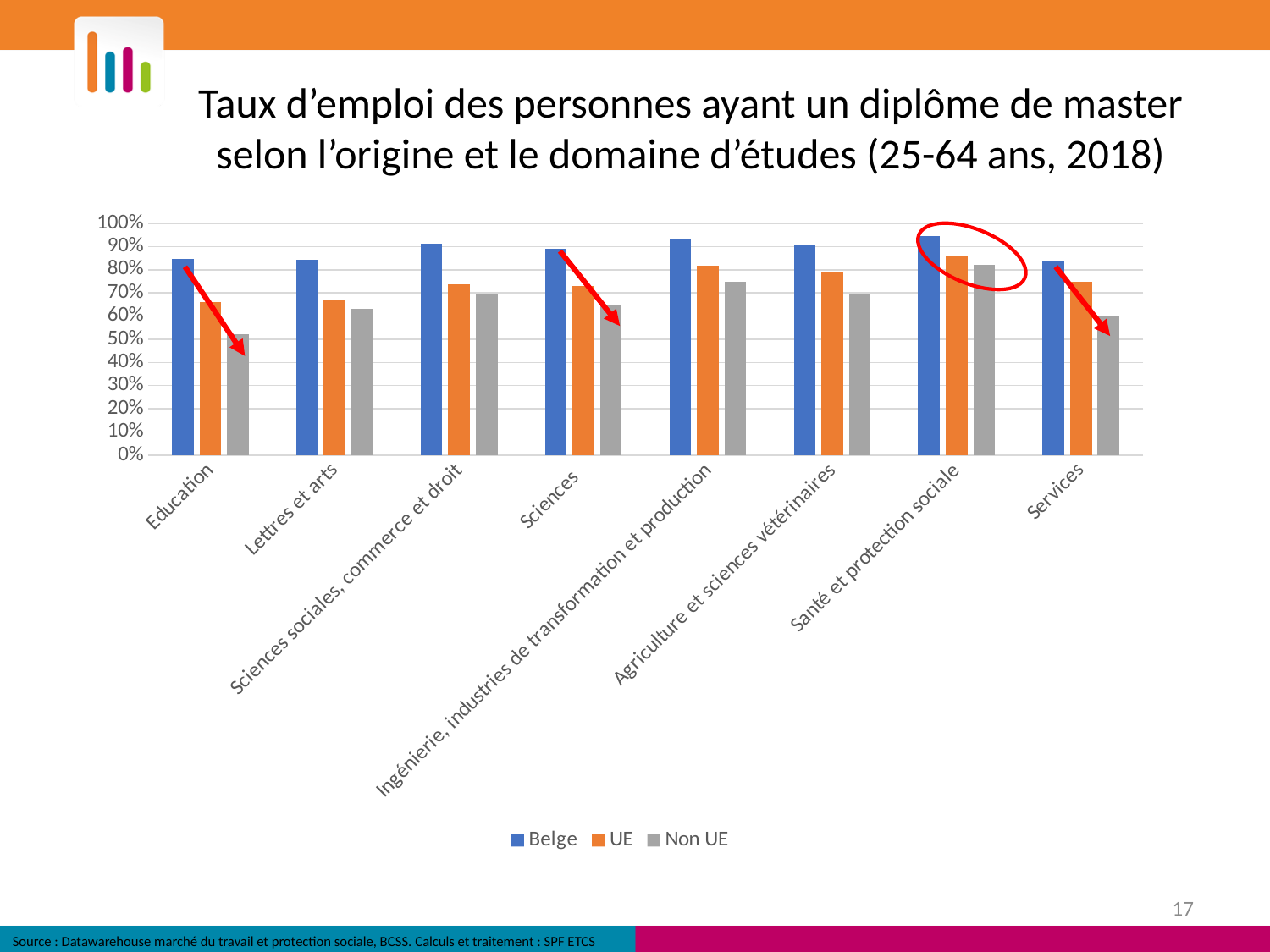
Which series is shown in orange in the legend? UE Which study domain has the highest employment rate for the Non UE series? Santé et protection sociale Is the Non UE value for Services greater or less than 70%? less Which study domain has the highest employment rate for the UE series? Santé et protection sociale For Education, which is larger: the Belge value or the Non UE value? Belge Is the Belge value for Santé et protection sociale greater or less than 90%? greater How many series does the legend list? 3 How many study domains (categories) are shown on the x axis? 8 Is the Non UE value for Education greater or less than 60%? less What kind of chart is shown on the slide? bar chart Which study domain has the lowest employment rate for the Non UE series? Education